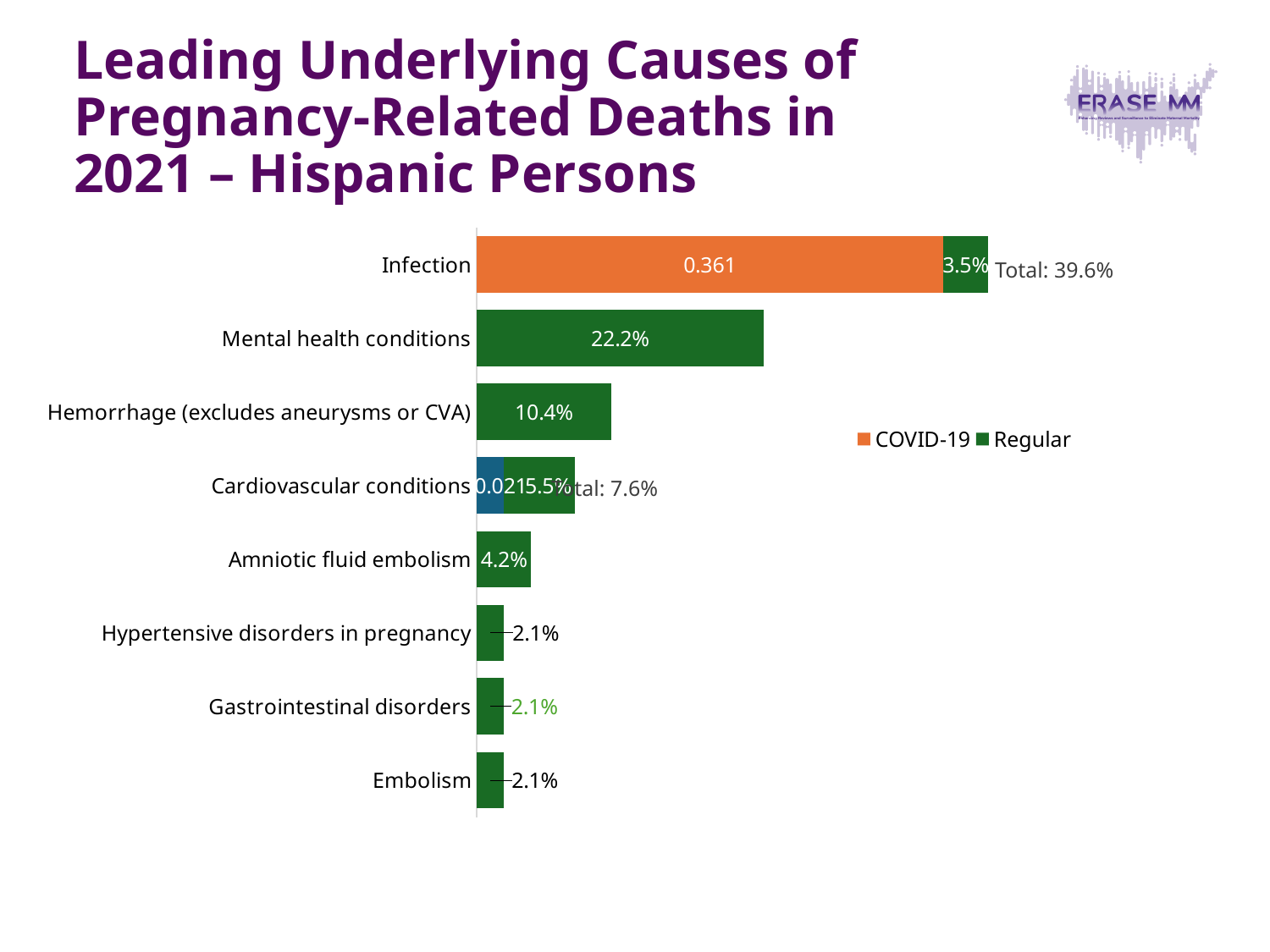
What total is shown for the Cardiovascular conditions bar? 7.6% What kind of chart is shown on the slide? bar chart How many categories (causes of death) are plotted on the chart? 8 How many series does the legend list? 2 What is the value shown for Hemorrhage (excludes aneurysms or CVA)? 10.4% What is the value shown for Amniotic fluid embolism? 4.2% What total is shown for the Infection bar? 39.6% Which cause has the longest bar on the chart? Infection What is the value of the Regular segment of the Infection bar? 3.5% What is the difference between the values for Mental health conditions and Hemorrhage (excludes aneurysms or CVA)? 11.8% What is the value shown for Mental health conditions? 22.2% What are the two series named in the legend? COVID-19 and Regular